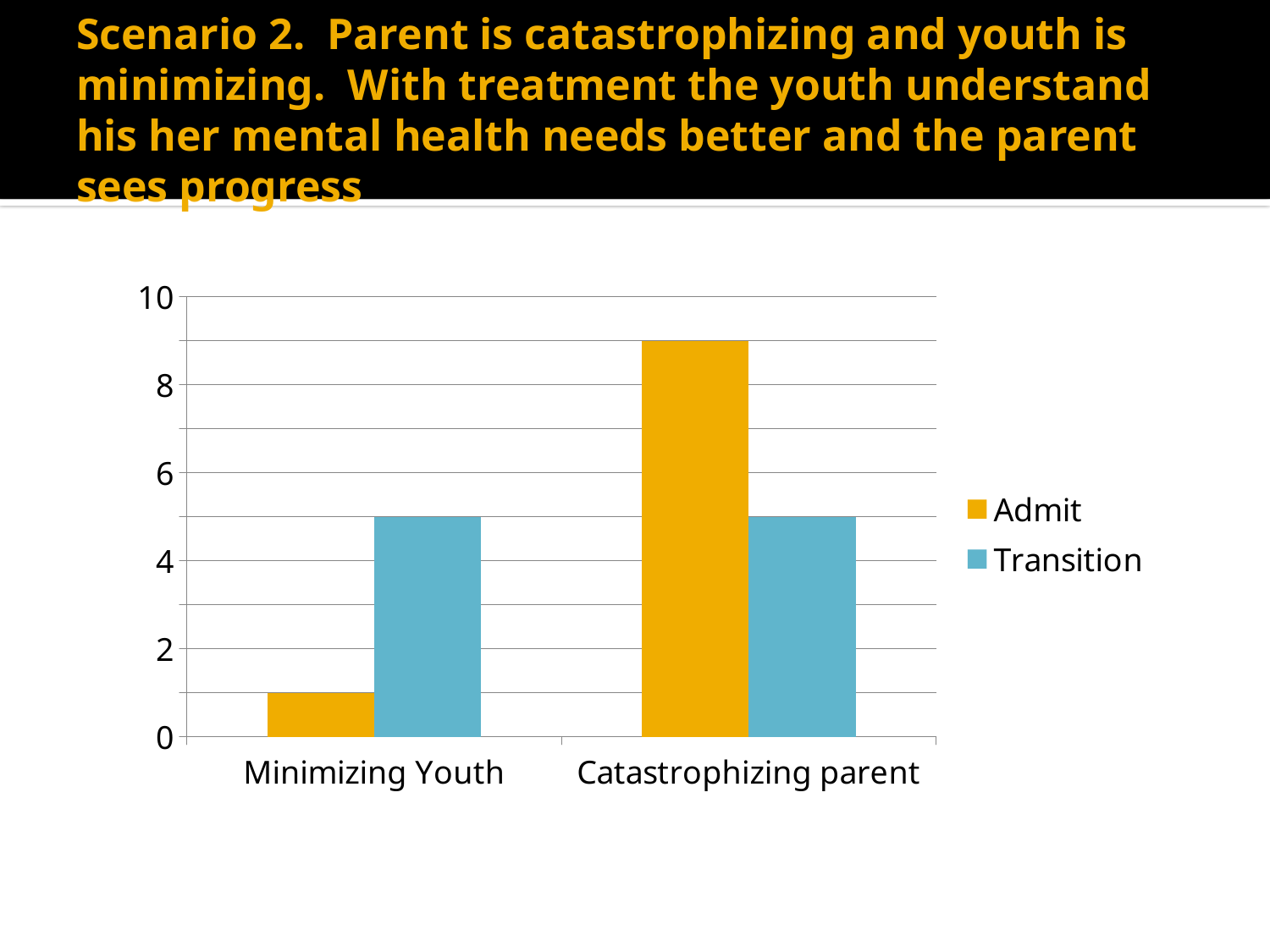
Is the Admit value for Catastrophizing parent greater or less than 8? greater Which category has the higher Admit value? Catastrophizing parent Is the Transition value for Catastrophizing parent greater or less than 6? less Is the Admit value for Minimizing Youth greater or less than 2? less How many categories are shown on the x axis of the chart? 2 How many series does the chart's legend list? 2 What kind of chart is shown on the slide? bar chart What are the two series named in the chart's legend? Admit and Transition Which colour represents the Admit series in the chart? yellow/orange For Catastrophizing parent, which is larger: the Admit value or the Transition value? Admit For Minimizing Youth, which is larger: the Admit value or the Transition value? Transition